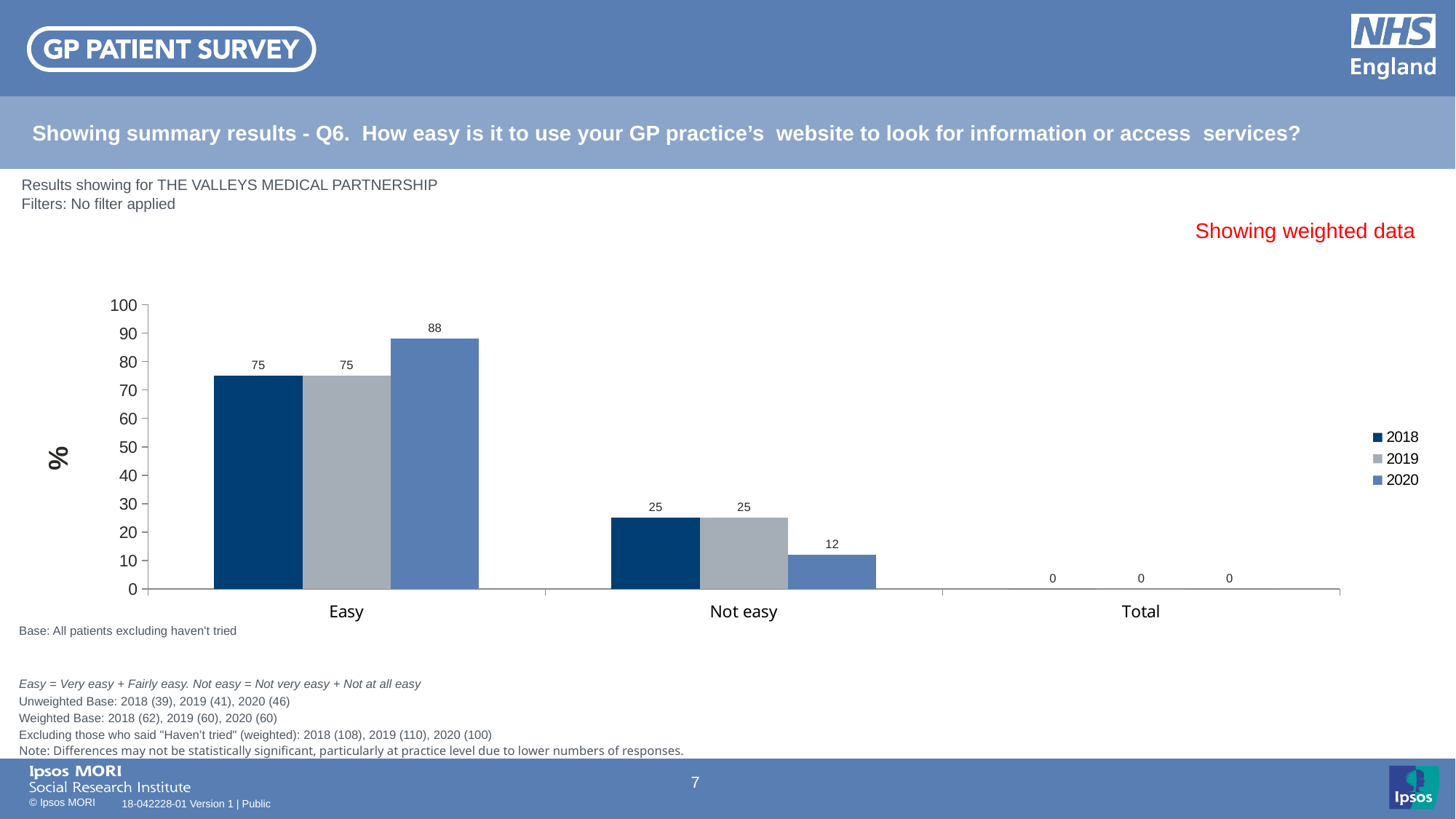
What is the difference between the Easy values for 2020 and 2019? 13 What is the value for Easy in 2020? 88 How many series does the legend list? 3 What label is shown on the vertical axis of the chart? % What is the difference between the Not easy values for 2019 and 2020? 13 What is the value for Not easy in 2018? 25 What kind of chart is shown on the slide? Bar chart Which year has the highest value for Easy? 2020 What is the value for Easy in 2019? 75 Which year has the lowest value for Not easy? 2020 Which is larger: Easy in 2018 or Not easy in 2018? Easy in 2018 What is the value for Not easy in 2020? 12